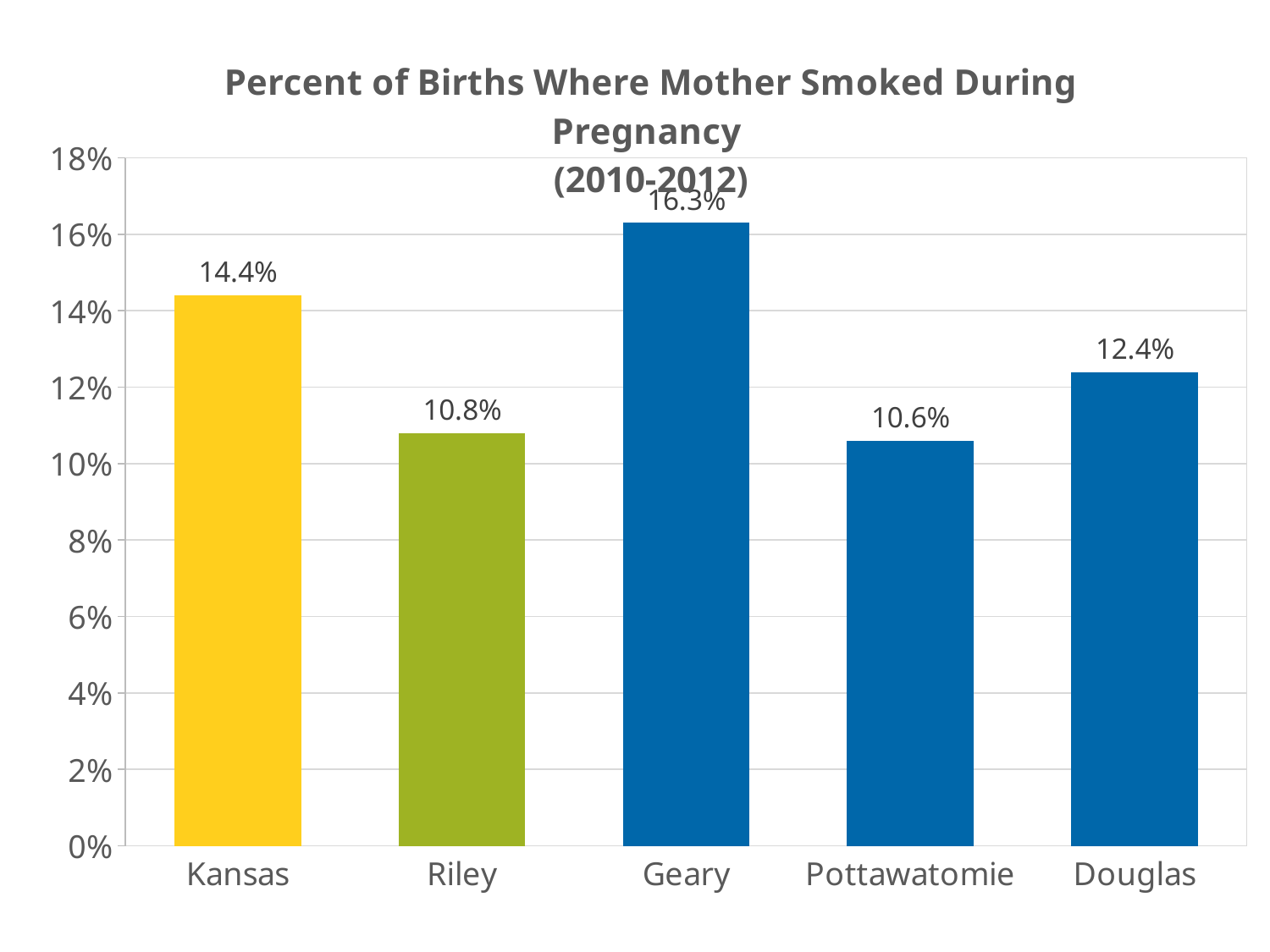
How many categories are shown on the x axis? 5 What is the value shown for Pottawatomie? 10.6% What is the difference between the values for Geary and Kansas? 1.9% What is the value shown for Riley? 10.8% Which category has the highest percent of births where the mother smoked during pregnancy? Geary What kind of chart is shown on the slide? Bar chart What is the percent of births where the mother smoked during pregnancy for Kansas? 14.4% Is the value for Douglas greater or less than 12%? greater What is the value shown for Douglas? 12.4% What is the value shown for Geary? 16.3% Which is larger, the value for Douglas or the value for Riley? Douglas Which category has the lowest percent of births where the mother smoked during pregnancy? Pottawatomie